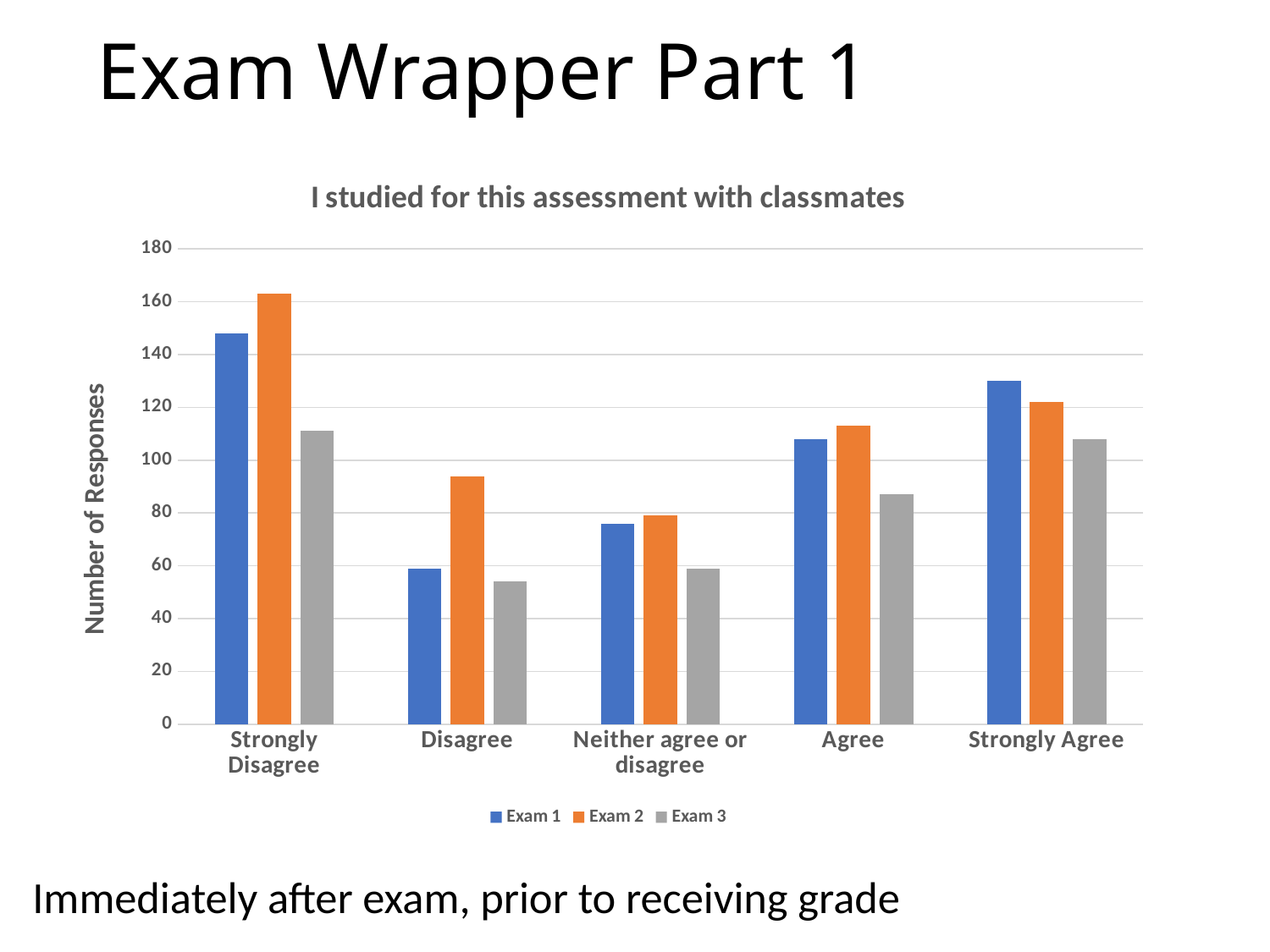
Which category has the highest value for Exam 2? Strongly Disagree Is the value for Exam 1 in the Strongly Agree category greater or less than 120? greater How many response categories are shown on the x axis? 5 What is the label on the y axis? Number of Responses Which category has the lowest value for Exam 1? Disagree In the Strongly Disagree category, which is larger: Exam 1 or Exam 2? Exam 2 Is the value for Exam 3 in the Agree category greater or less than 100? less Is the value for Exam 2 in the Strongly Disagree category greater or less than 140? greater What kind of chart is shown on the slide? bar chart How many series does the legend list? 3 What is the title of the chart? I studied for this assessment with classmates